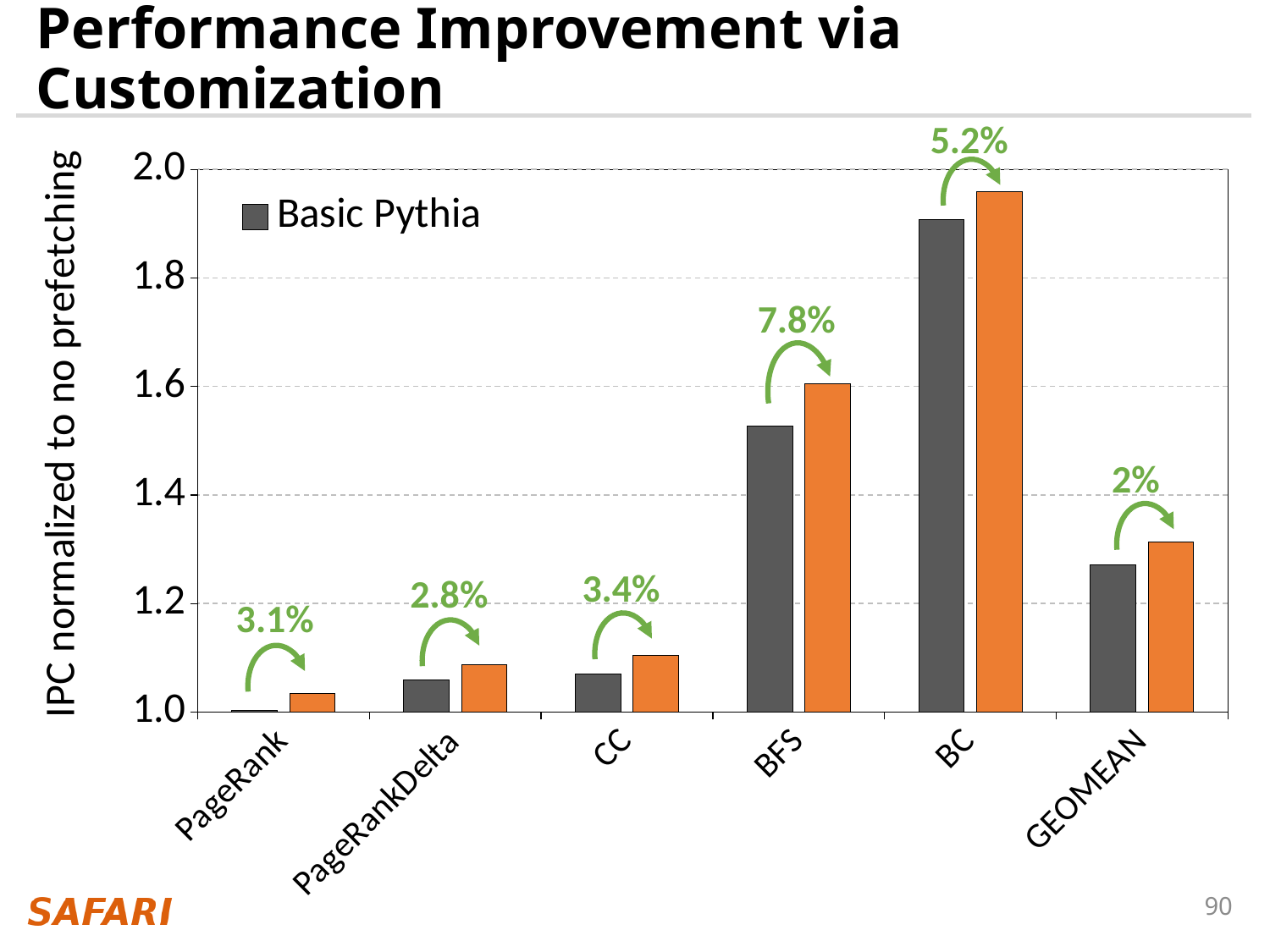
What is the label of the y axis? IPC normalized to no prefetching How many series does the chart's legend list? 1 Which category has the largest annotated percentage improvement? BFS Which category has the highest IPC bars in the chart? BC What kind of chart is shown on the slide? bar chart What is the percentage improvement annotated above the GEOMEAN bars? 2% What is the percentage improvement annotated above the BFS bars? 7.8% How many categories are shown on the x axis of the chart? 6 Which category has the lowest IPC bars in the chart? PageRank What is the percentage improvement annotated above the PageRankDelta bars? 2.8% Is the orange bar value for GEOMEAN greater or less than 1.4? less Is the Basic Pythia value for BC greater or less than 1.8? greater